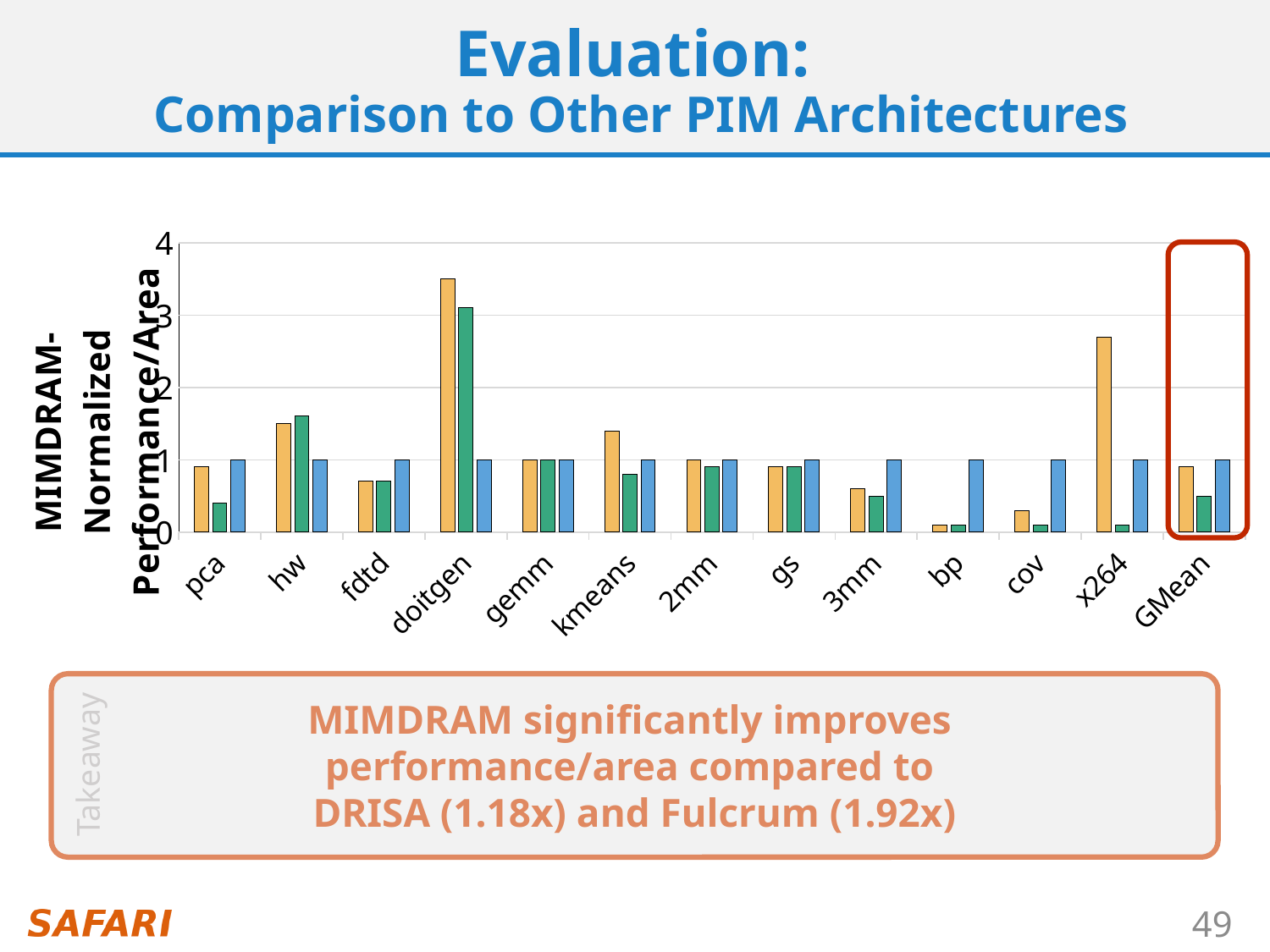
Is the orange bar for x264 greater or less than 2? greater Is the orange bar for doitgen greater or less than 3? greater How many bars are plotted for each category in the chart? 3 Which category has the tallest green bar? doitgen How many categories are shown along the x axis of the chart? 13 Which is larger for kmeans, the orange bar or the green bar? the orange bar What value does the blue bar for GMean reach on the y axis? 1 Is the orange bar for bp greater or less than 1? less What is the label of the y axis of the chart? MIMDRAM-Normalized Performance/Area What kind of chart is shown on the slide? bar chart Which category has the tallest orange bar? doitgen